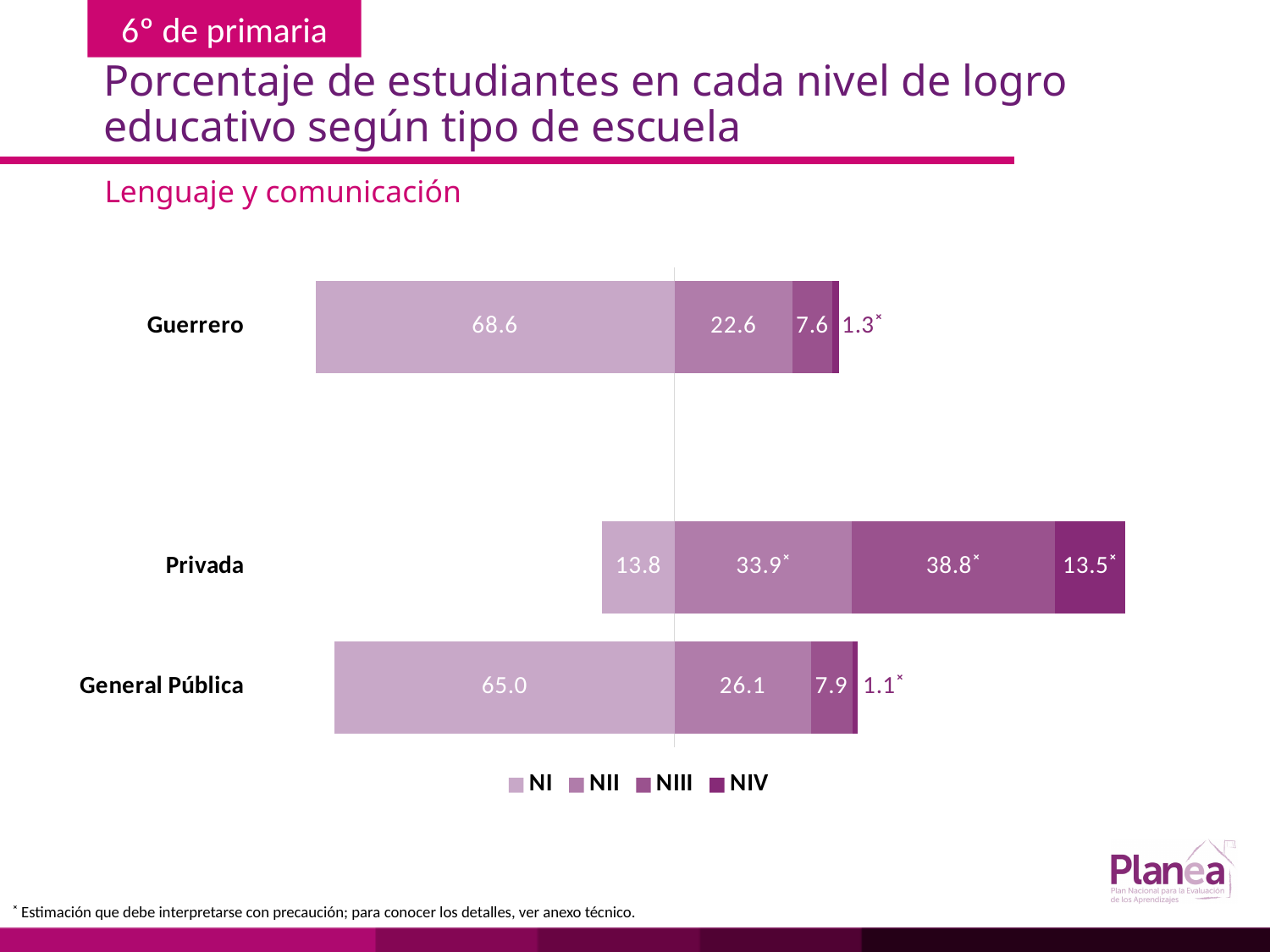
Which school type has the highest NI value? Guerrero What is the total of the stacked bar for Privada? 100.0 Which school type has the lowest NIV value? General Pública What is the difference between the NI values for Guerrero and General Pública? 3.6 How many series does the legend list? 4 Which is larger, the NII value for Privada or the NII value for Guerrero? Privada How many school types are shown on the chart? 3 What is the NIII value for Privada? 38.8 What is the NII value for General Pública? 26.1 What kind of chart is shown on the slide? Stacked bar chart What is the NI value for Guerrero? 68.6 What is the NIV value for General Pública? 1.1